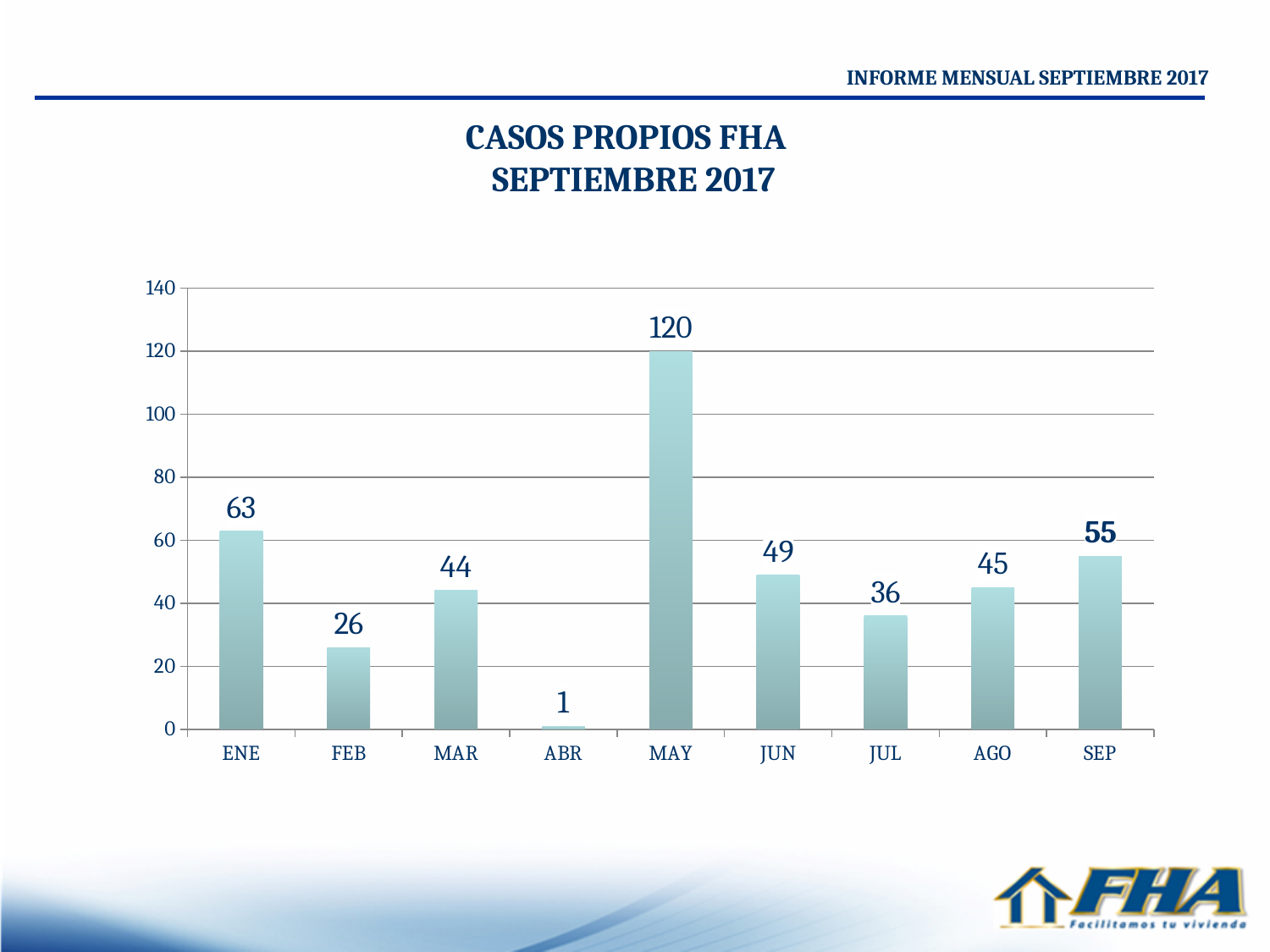
What kind of chart is shown on the slide? bar chart Which is larger, the value for JUL or the value for AGO? AGO What is the difference between the values for MAY and JUN? 71 What is the value for SEP? 55 Is the value for ENE greater or less than 60? greater What is the difference between the values for ENE and SEP? 8 How many months are shown on the x axis? 9 What is the value for FEB? 26 Which month has the lowest value? ABR What is the title of the chart? CASOS PROPIOS FHA SEPTIEMBRE 2017 Which month has the highest value? MAY What is the value for MAY? 120